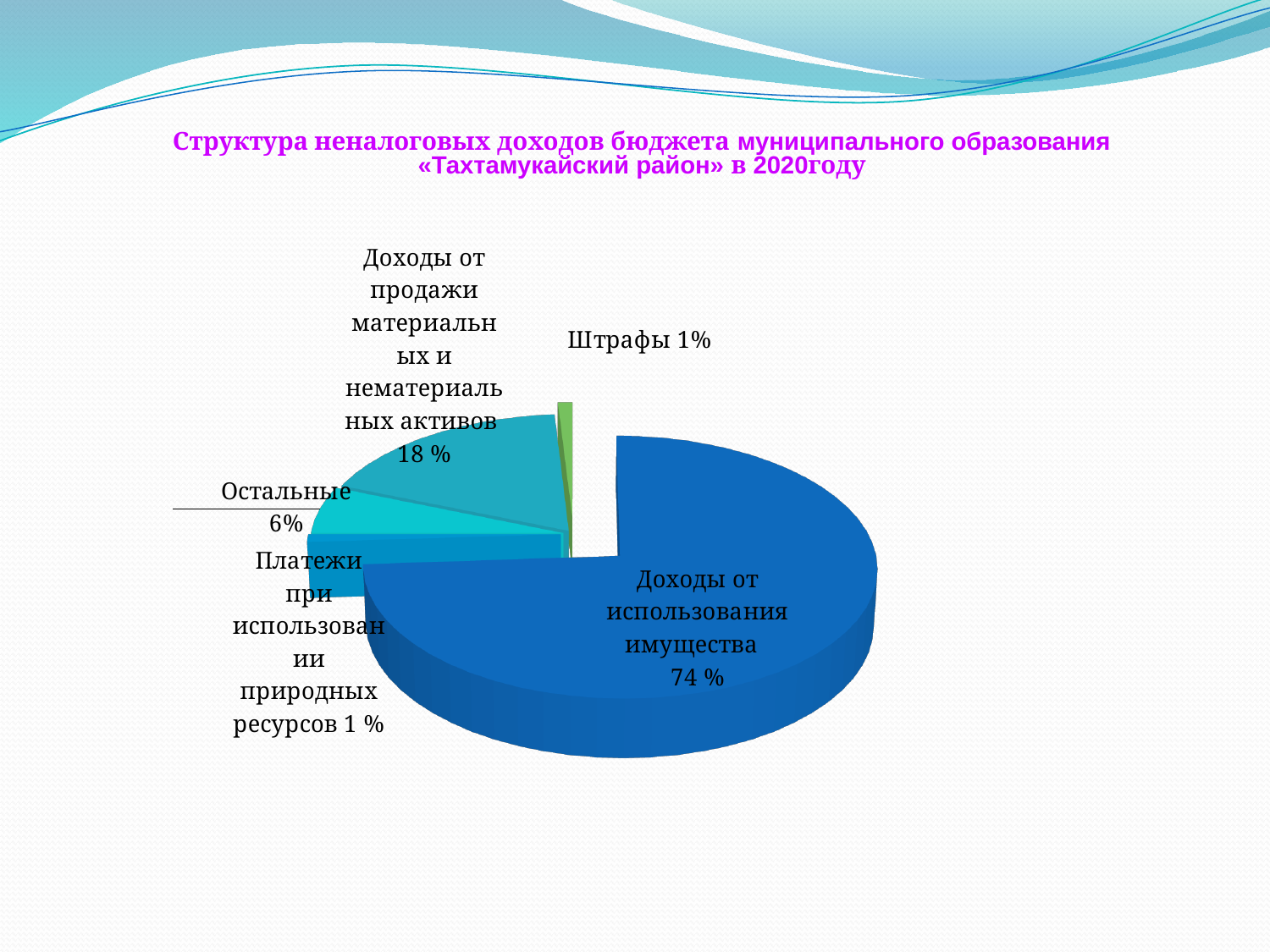
What is the difference in percentage points between "Доходы от использования имущества" and "Доходы от продажи материальных и нематериальных активов"? 56 What is the title of the slide? Структура неналоговых доходов бюджета муниципального образования «Тахтамукайский район» в 2020году What share of the pie does "Доходы от использования имущества" represent? 74 % Which is larger: "Остальные" or "Штрафы"? Остальные What type of chart is shown on the slide? Pie chart How many slices does the pie chart have? 5 What is the difference in percentage points between "Доходы от продажи материальных и нематериальных активов" and "Остальные"? 12 What is the value shown for "Остальные"? 6% Which category has the largest slice of the pie? Доходы от использования имущества What is the value shown for "Доходы от продажи материальных и нематериальных активов"? 18 % What is the value shown for "Штрафы"? 1% What is the value shown for "Платежи при использовании природных ресурсов"? 1 %